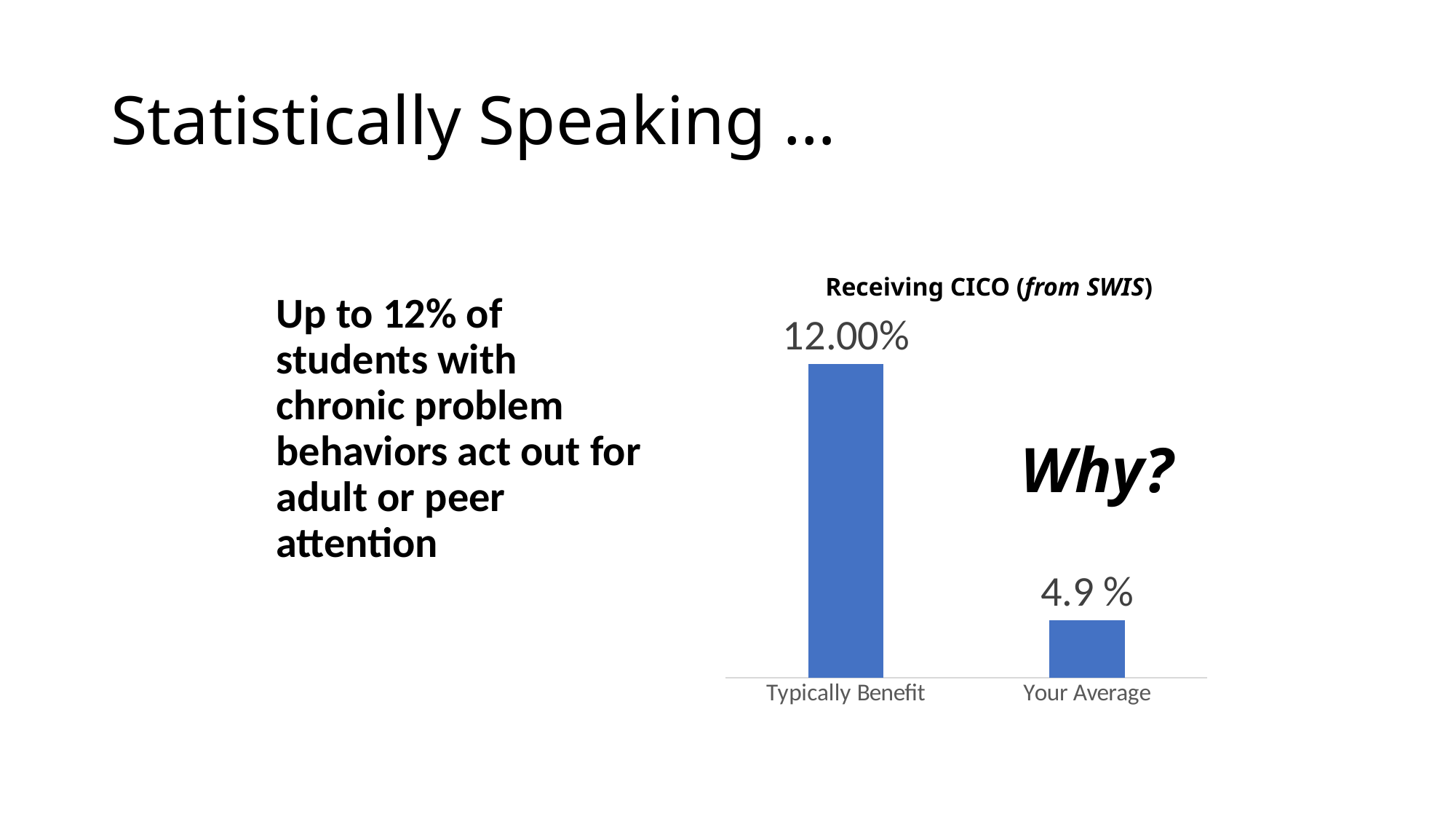
Which category has the lowest value? Your Average What is the value for Typically Benefit? 12.00% What colour are the bars in the chart? Blue What is the value for Your Average? 4.9 % What kind of chart is shown on the slide? Bar chart What is the title of the chart? Receiving CICO (from SWIS) How many categories are shown in the chart? 2 Do the values rise or fall from left to right across the categories? Fall Which is larger, Typically Benefit or Your Average? Typically Benefit Which category has the highest value? Typically Benefit What is the difference between the Typically Benefit value and the Your Average value? 7.1%